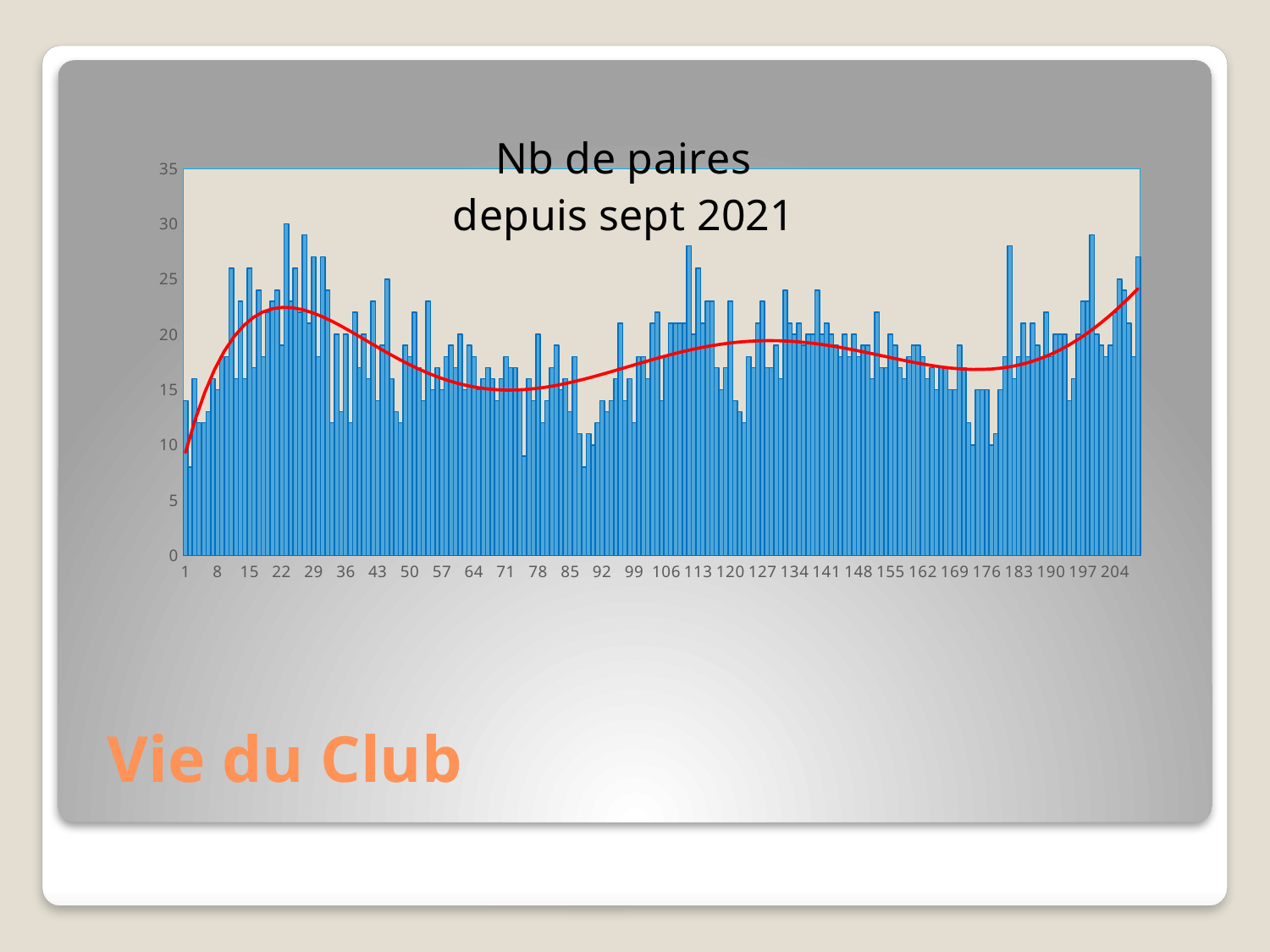
Is the value of the tallest bar greater or less than 25? greater What kind of chart is shown on the slide? bar chart Is the value of the shortest bar greater or less than 10? less What is the title of the chart? Nb de paires depuis sept 2021 Does the red trend line rise or fall between category 1 and category 22? rise What colour is the smooth trend line drawn over the bars? red Is the value for category 1 (the first bar) greater or less than 20? less What is the highest value shown on the y axis? 35 Does the red trend line rise or fall over the last categories at the right end of the x axis? rise